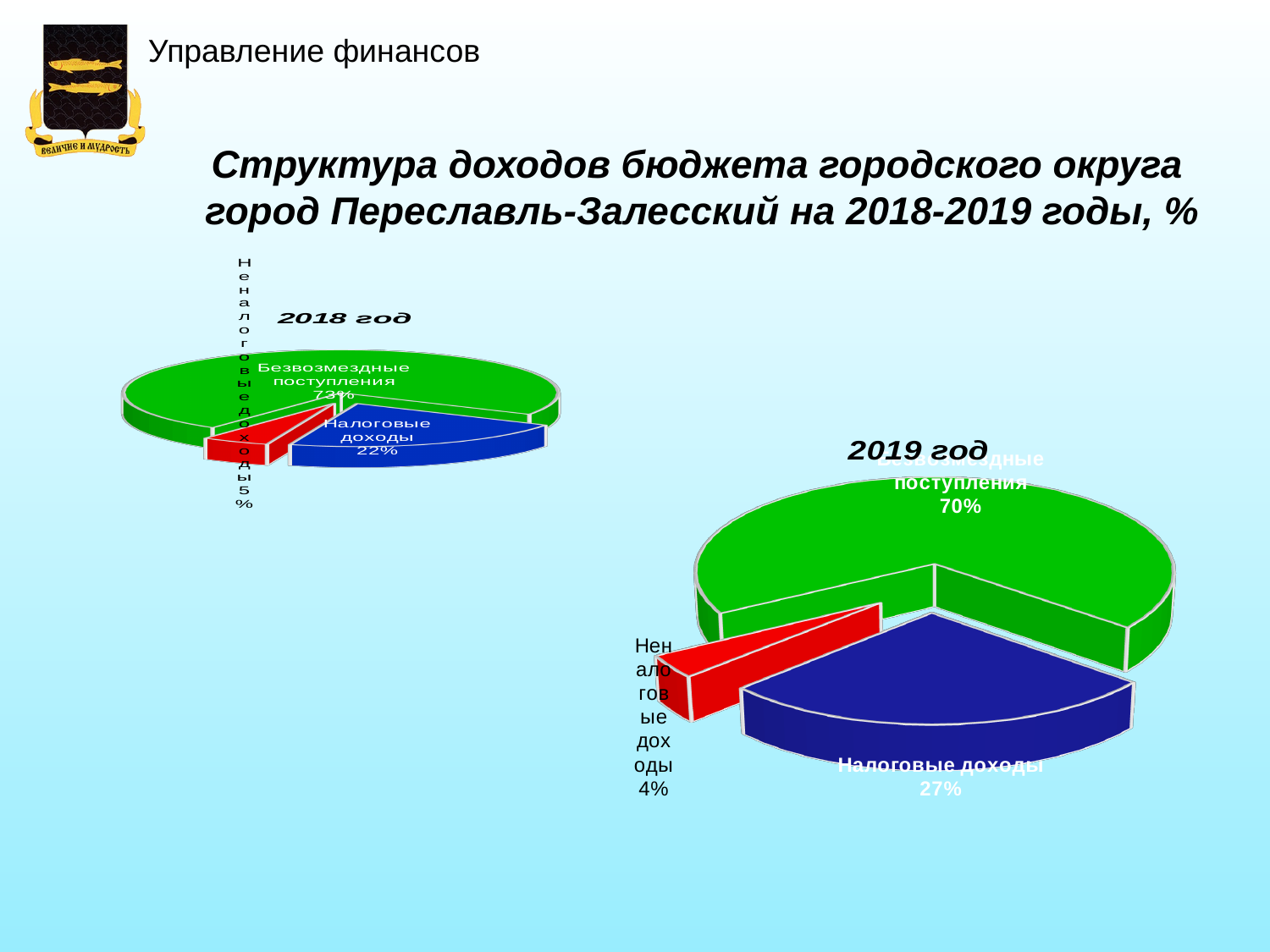
In the "2019 год" pie chart, what share is shown for Безвозмездные поступления? 70% In the "2019 год" pie chart, what share is shown for Неналоговые доходы? 4% What type of chart is used for "2018 год"? Pie chart In the "2018 год" pie chart, what share is shown for Безвозмездные поступления? 73% In the "2018 год" pie chart, which category has the smallest slice? Неналоговые доходы In the "2018 год" pie chart, what share is shown for Неналоговые доходы? 5% In the "2019 год" pie chart, what share is shown for Налоговые доходы? 27% In the "2018 год" pie chart, what share is shown for Налоговые доходы? 22% In the "2019 год" pie chart, which category has the largest slice? Безвозмездные поступления Which is larger: Налоговые доходы in the "2018 год" chart or Налоговые доходы in the "2019 год" chart? 2019 год In the "2019 год" pie chart, what is the difference in percentage points between Безвозмездные поступления and Налоговые доходы? 43 How many categories does the "2019 год" pie chart show? 3